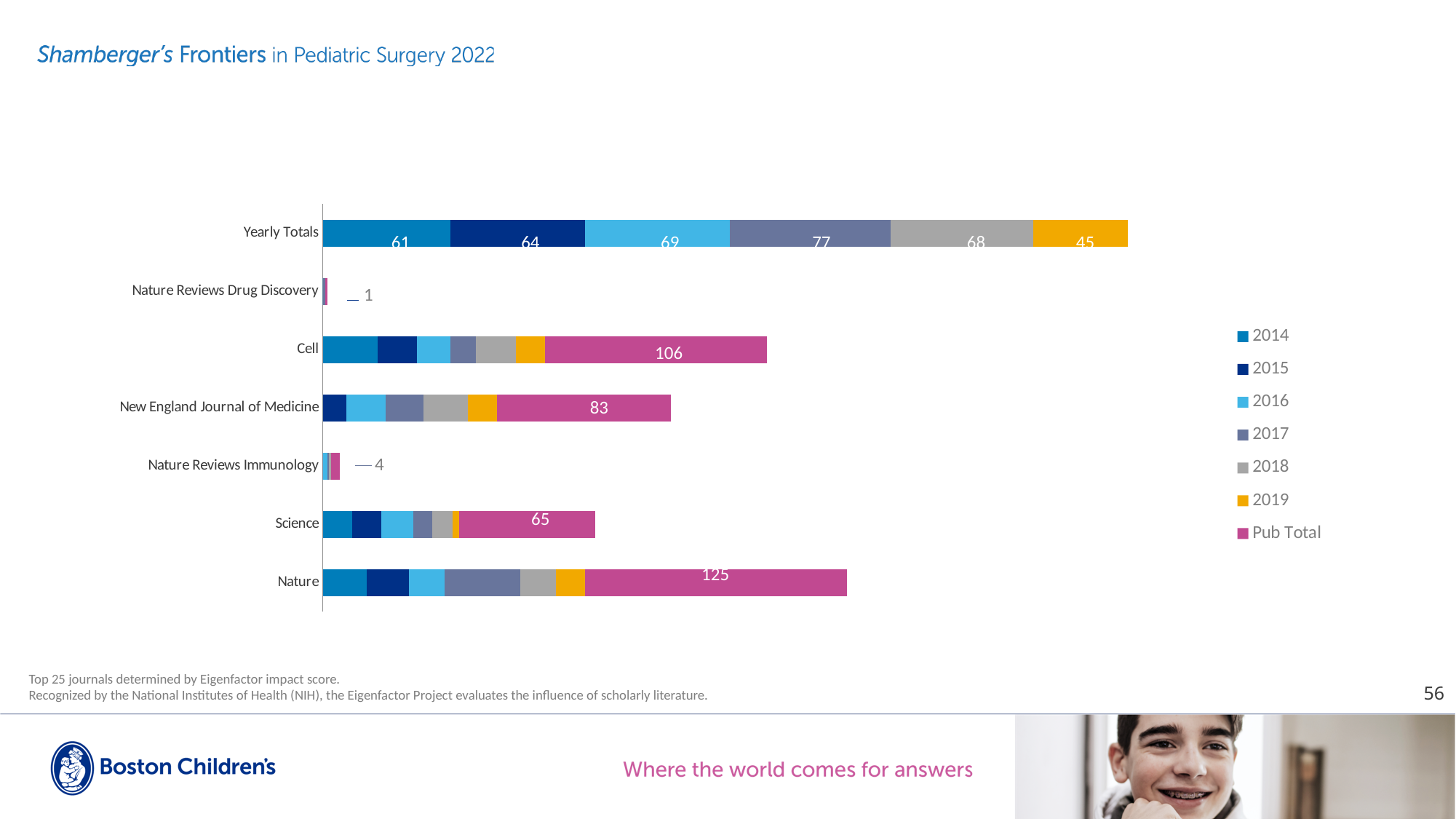
What is the Pub Total value for Nature? 125 What kind of chart is shown on the slide? Stacked bar chart In the Yearly Totals bar, what is the value for 2019? 45 What is the Pub Total value for Cell? 106 Which year has the lowest value in the Yearly Totals bar? 2019 What is the difference between the Pub Total for Nature and the Pub Total for Cell? 19 Which has the larger Pub Total, Cell or New England Journal of Medicine? Cell Which journal has the highest Pub Total? Nature How many series does the legend list? 7 In the Yearly Totals bar, what is the value for 2017? 77 What is the total of the Yearly Totals stacked bar (2014 through 2019)? 384 Which year has the highest value in the Yearly Totals bar? 2017